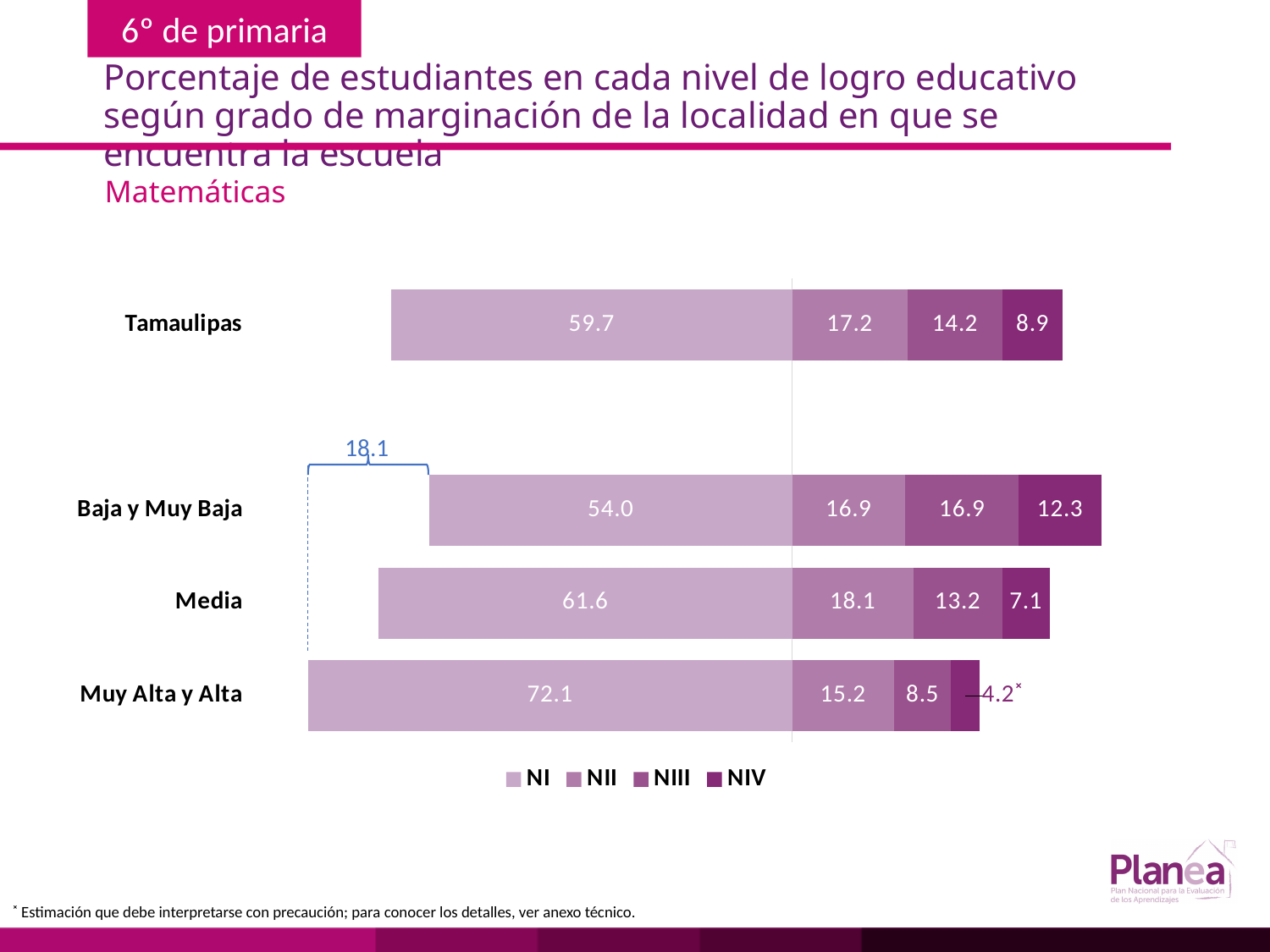
Which category has the highest NI value? Muy Alta y Alta How many categories are plotted on the chart? 4 What is the NIII value for Muy Alta y Alta? 8.5 What is the NIV value for Baja y Muy Baja? 12.3 What is the NI value for Tamaulipas? 59.7 What is the difference between the NI values for Muy Alta y Alta and Baja y Muy Baja? 18.1 Which category has the lowest NIV value? Muy Alta y Alta Which is larger, the NIII value for Tamaulipas or the NIII value for Media? Tamaulipas What is the total of the stacked bar for Media? 100.0 What type of chart is shown on the slide? Stacked bar chart How many series does the legend list? 4 What is the NII value for Media? 18.1